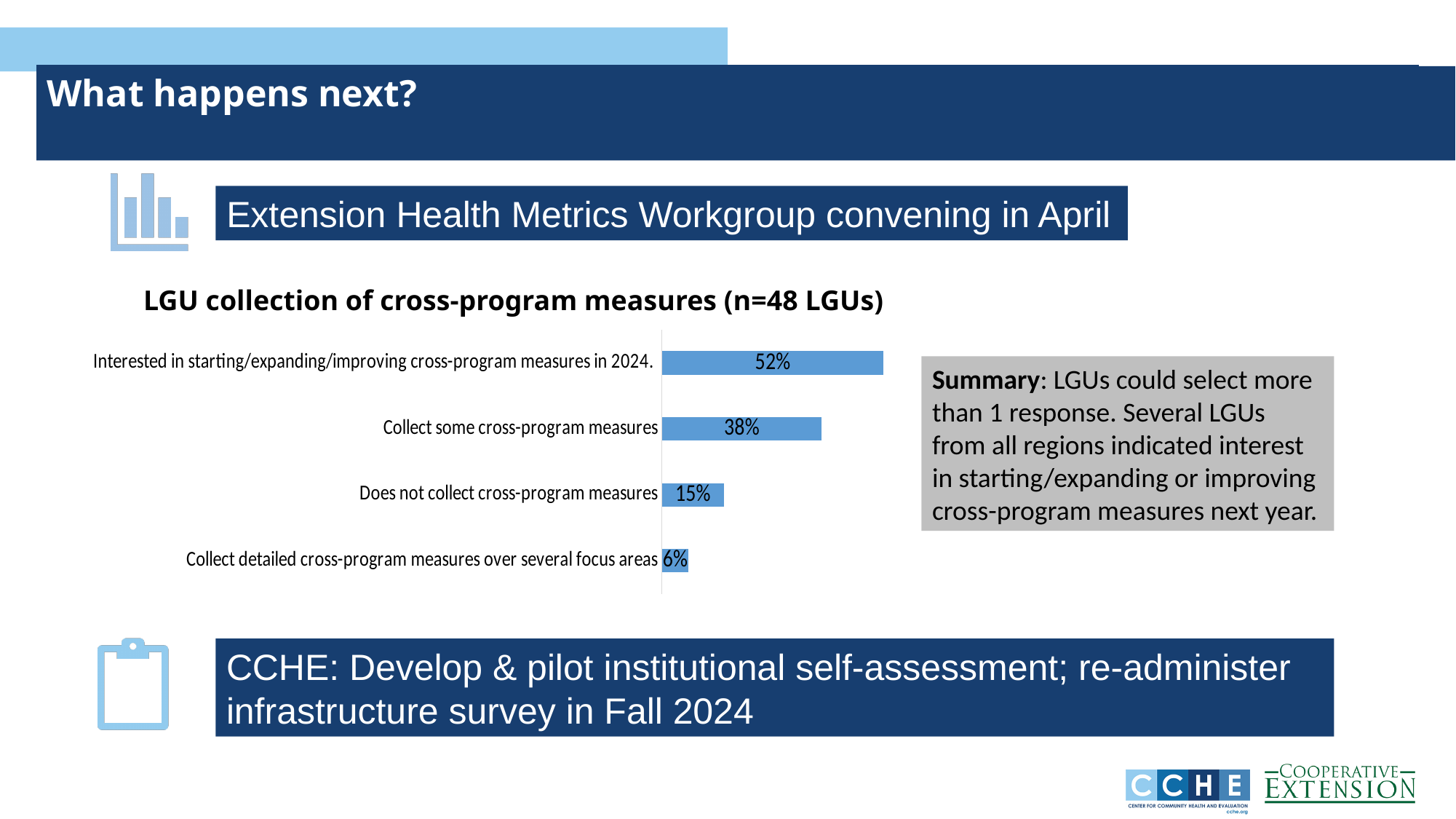
How many LGUs are included in the chart's sample (n)? 48 Which category has the highest percentage in the chart? Interested in starting/expanding/improving cross-program measures in 2024. What percentage of LGUs do not collect cross-program measures? 15% What is the difference in percentage points between 'Collect some cross-program measures' and 'Does not collect cross-program measures'? 23 percentage points What percentage of LGUs are interested in starting/expanding/improving cross-program measures in 2024? 52% What is the title of the chart? LGU collection of cross-program measures (n=48 LGUs) Which is larger: the percentage that collect some cross-program measures or the percentage that do not collect cross-program measures? Collect some cross-program measures How many categories are shown in the chart? 4 What percentage of LGUs collect detailed cross-program measures over several focus areas? 6% Which category has the lowest percentage in the chart? Collect detailed cross-program measures over several focus areas What percentage of LGUs collect some cross-program measures? 38% What type of chart is shown on the slide? Bar chart